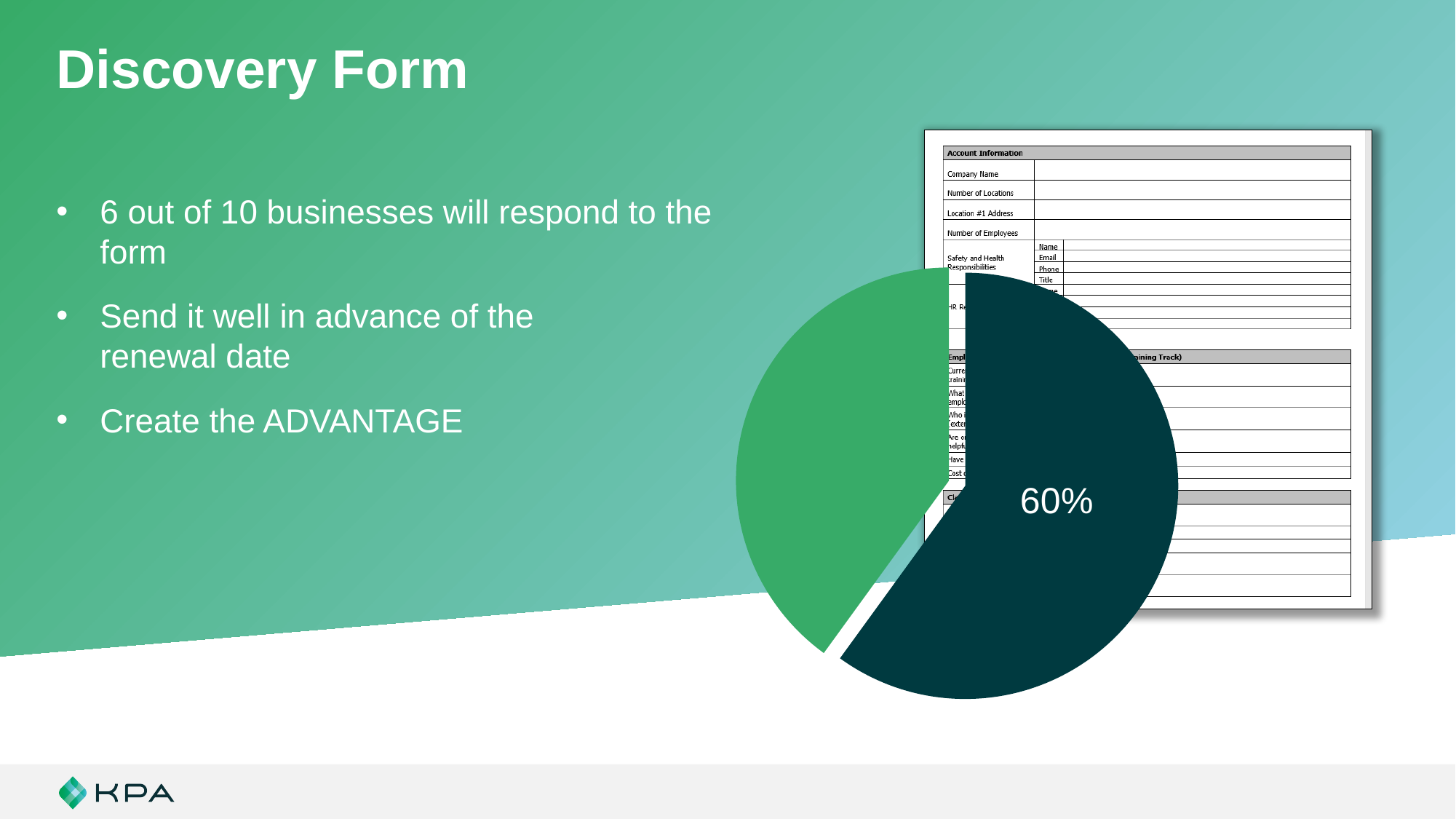
What share of the pie does the labelled dark slice represent? 60% Is the value of the green slice greater or less than 50%? less How many slices does the pie chart have? 2 Which slice of the pie chart is the largest? The dark teal slice (60%) Which slice of the pie chart is the smallest? The green slice Is the value of the dark teal slice greater or less than 50%? greater Which slice of the pie chart is larger, the dark teal slice or the green slice? The dark teal slice What kind of chart is shown on the slide? Pie chart What percentage is printed on the dark teal slice of the pie chart? 60% How many slices of the pie chart carry a printed data label? 1 What colour is the slice of the pie chart that is labelled 60%? Dark teal